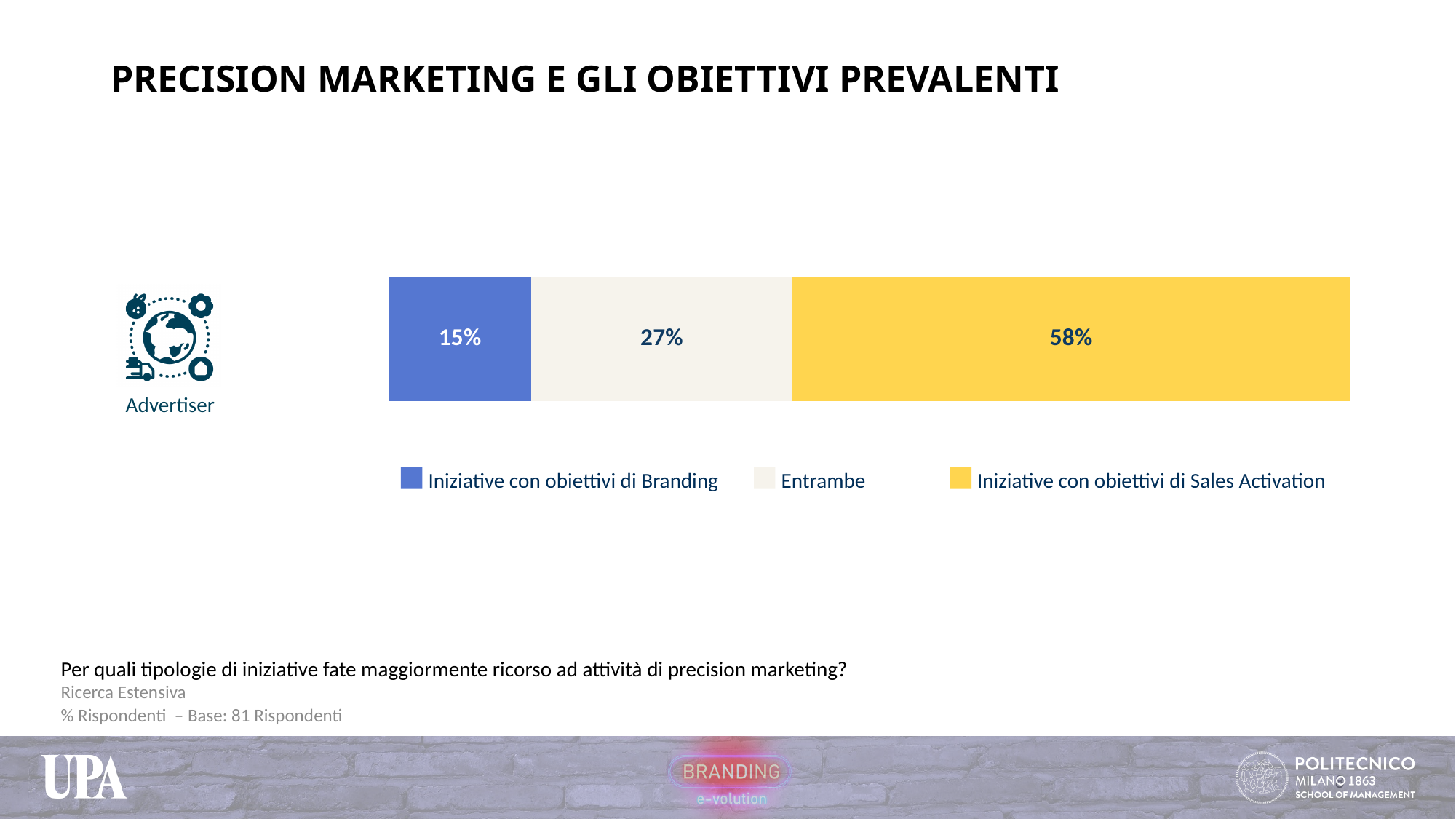
What colour represents Iniziative con obiettivi di Sales Activation in the chart? Yellow Which segment of the Advertiser bar has the lowest value? Iniziative con obiettivi di Branding What is the difference between the Sales Activation share and the Branding share in the Advertiser bar? 43 percentage points How many series does the legend list? 3 Which segment of the Advertiser bar has the highest value? Iniziative con obiettivi di Sales Activation What percentage of Advertiser respondents use precision marketing for initiatives with Sales Activation objectives? 58% What kind of chart is shown on the slide? Stacked bar chart What is the base of respondents stated on the slide? 81 Rispondenti Which is larger for Advertiser: Entrambe or Iniziative con obiettivi di Branding? Entrambe What percentage of Advertiser respondents use precision marketing for initiatives with Branding objectives (Iniziative con obiettivi di Branding)? 15% What is the total of the three segments in the Advertiser stacked bar? 100% What percentage of Advertiser respondents answered Entrambe (both)? 27%